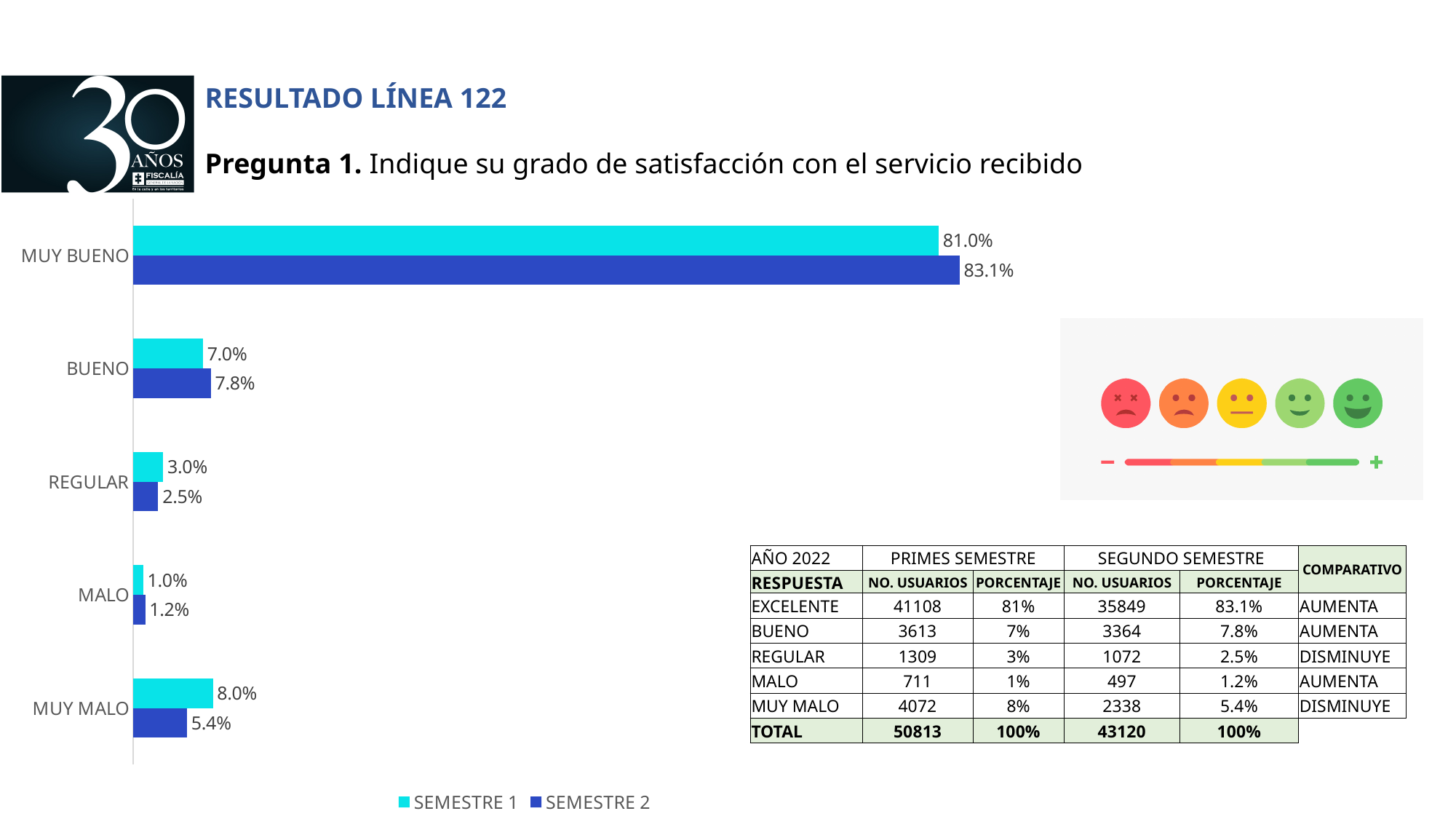
What are the two series named in the chart legend? SEMESTRE 1 and SEMESTRE 2 What is the SEMESTRE 1 value for REGULAR? 3.0% What is the SEMESTRE 2 value for BUENO? 7.8% What is the SEMESTRE 1 value for MUY BUENO? 81.0% How many series does the legend list? 2 What kind of chart is shown on the slide? Bar chart Which category has the highest SEMESTRE 2 value? MUY BUENO What is the SEMESTRE 2 value for MUY MALO? 5.4% Which category has the lowest SEMESTRE 1 value? MALO Which is larger for MUY MALO: the SEMESTRE 1 value or the SEMESTRE 2 value? SEMESTRE 1 What is the difference between the SEMESTRE 2 and SEMESTRE 1 values for MUY BUENO? 2.1% How many categories are shown on the chart? 5